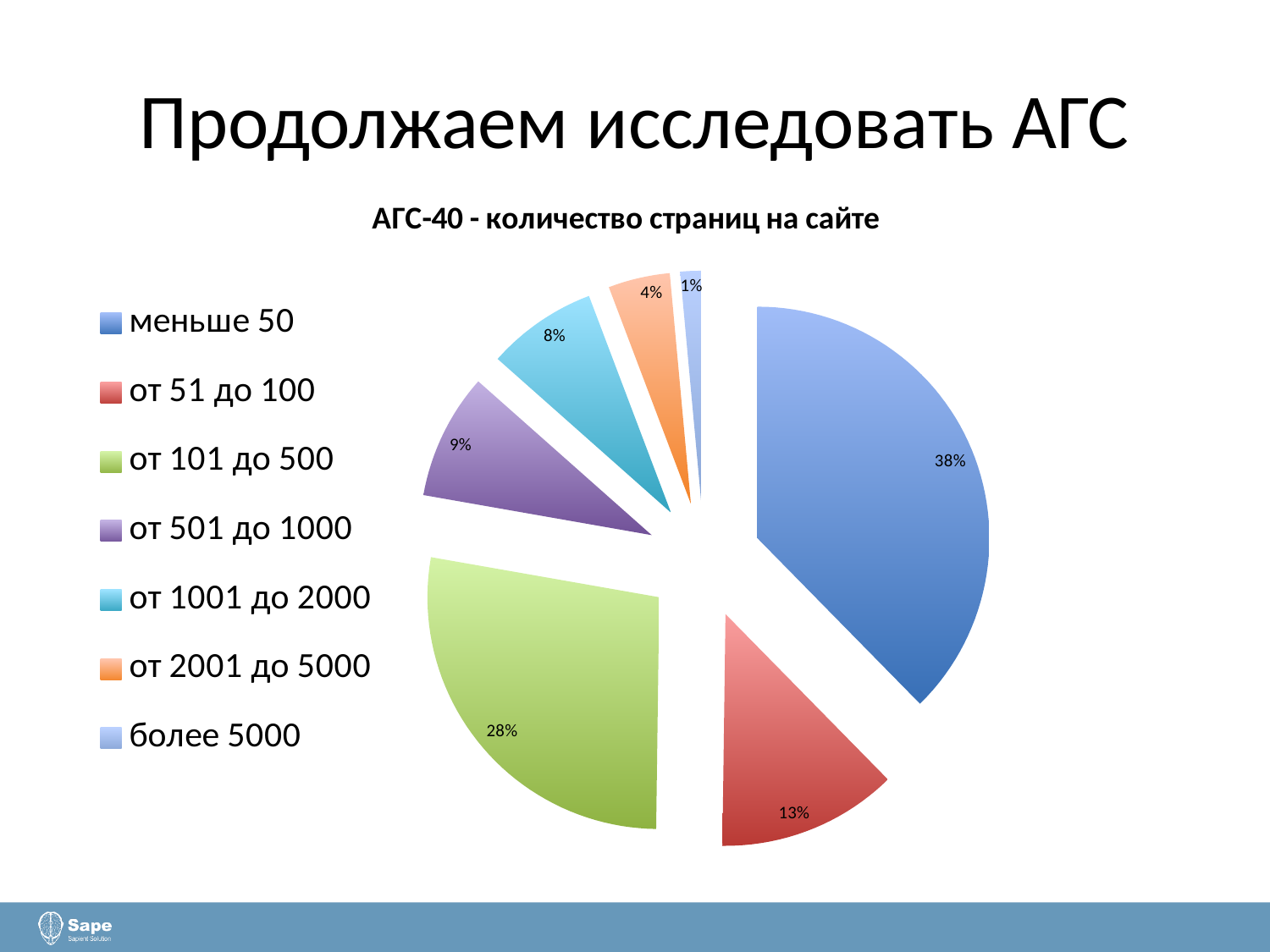
What is the value shown for 'от 1001 до 2000'? 8% What is the value shown for 'более 5000'? 1% Which is larger: the share for 'от 501 до 1000' or for 'от 2001 до 5000'? от 501 до 1000 What is the title of the chart? АГС-40 - количество страниц на сайте How many categories does the pie chart show? 7 Which category has the largest slice of the pie? меньше 50 What is the value shown for 'от 101 до 500'? 28% What kind of chart is shown on the slide? pie chart What share of the pie does the 'меньше 50' slice represent? 38% Which category has the smallest slice of the pie? более 5000 What is the value shown for 'от 51 до 100'? 13% What is the difference between the shares for 'меньше 50' and 'от 101 до 500'? 10%